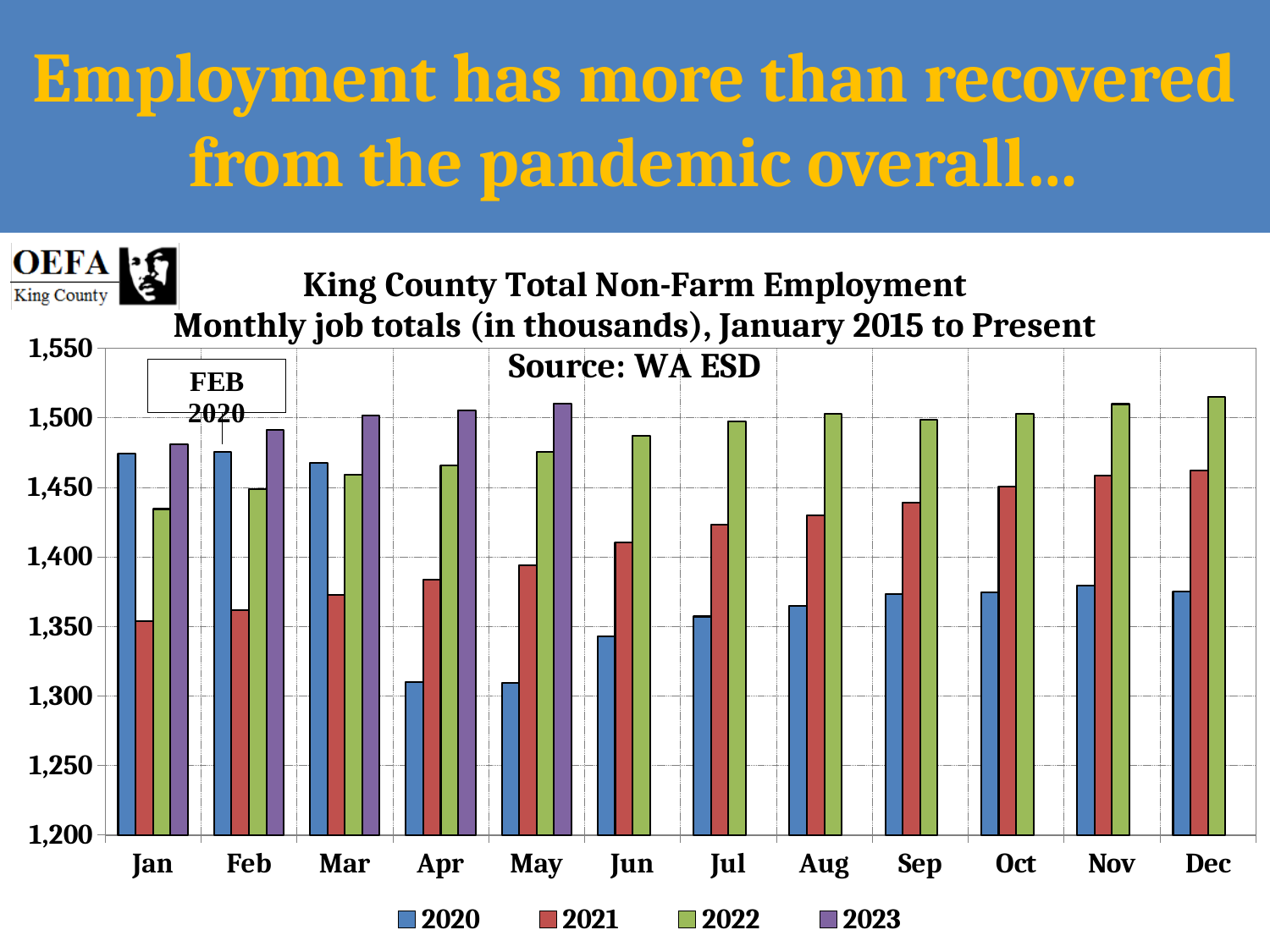
How many series does the legend list? 4 Is the 2021 value for Jan greater or less than 1,400? less Do the 2021 values rise or fall from Jan to Dec? rise What kind of chart is shown on the slide? bar chart Which is larger in Dec, the 2021 value or the 2022 value? 2022 In which month is the 2021 value lowest? Jan Is the 2022 value for Dec greater or less than 1,500? greater What source is cited in the chart title? WA ESD Is the 2022 value for Jan greater or less than 1,450? less How many months are shown along the x axis? 12 Which is larger in Jan, the 2020 value or the 2021 value? 2020